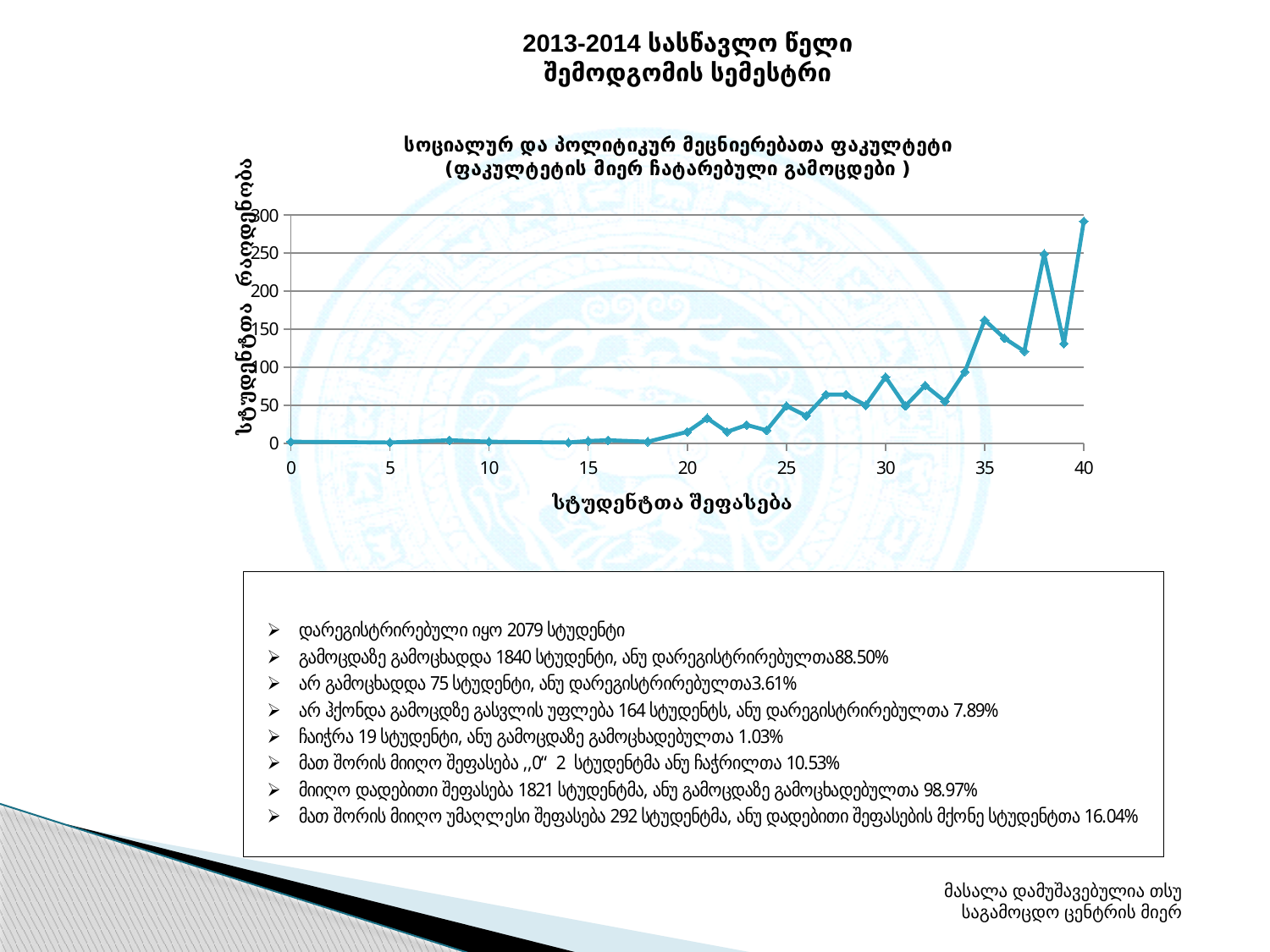
Is the number of students at score 20 greater or less than 50? less What is the label of the y axis of the chart? სტუდენტთა რაოდენობა Which has more students: score 40 or score 38? score 40 At which student score (x-axis value) does the number of students reach its highest point? 40 Is the number of students at score 40 greater or less than 250? greater Overall, do the values rise or fall as the student score increases along the x axis? rise What is the label of the x axis of the chart? სტუდენტთა შეფასება Is the number of students at score 10 greater or less than 50? less What kind of chart is shown on the slide? line chart Which has more students: score 36 or score 37? score 36